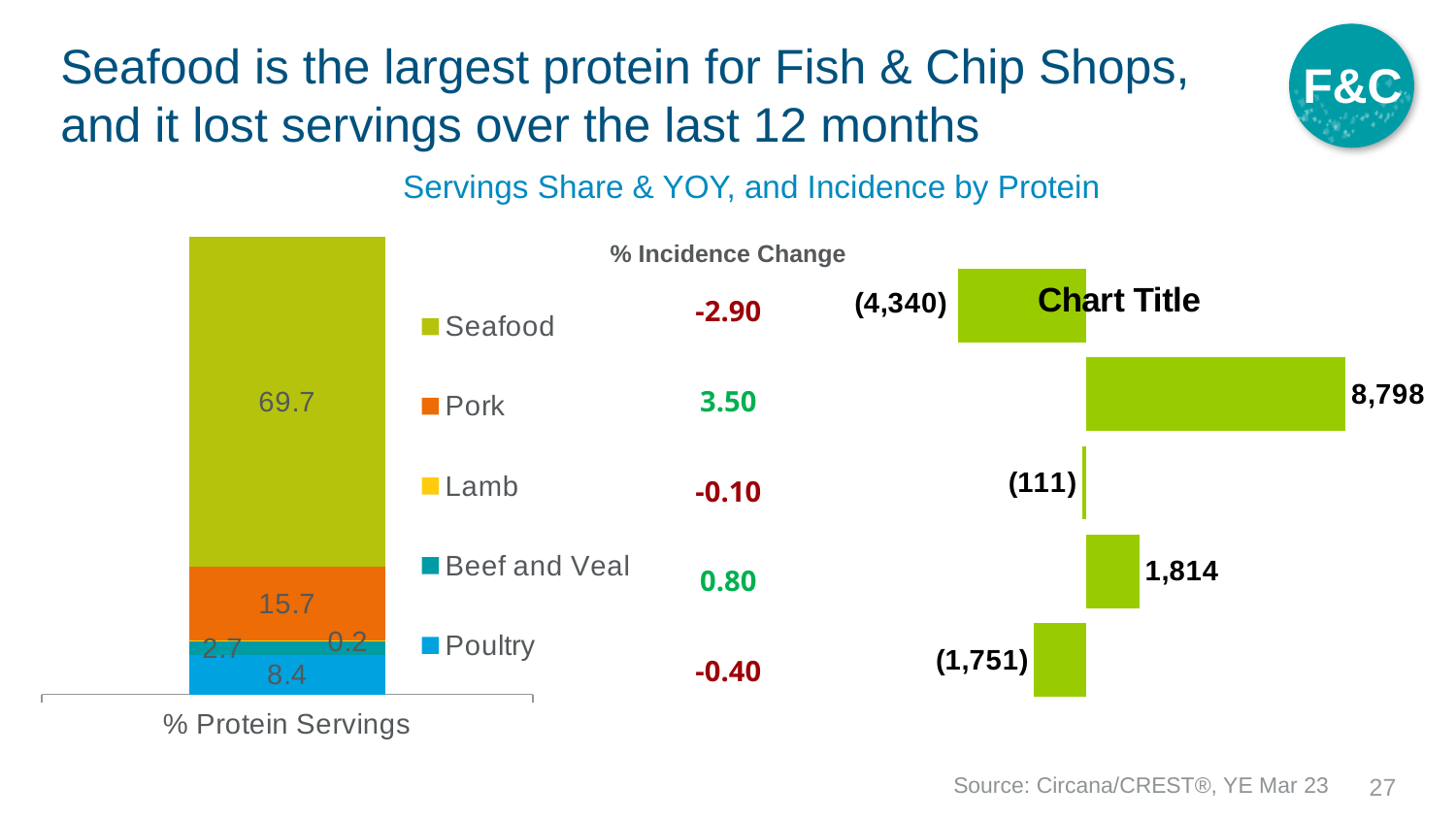
In the chart on the right titled "Chart Title", what is the value of the top bar? (4,340) In the chart on the right titled "Chart Title", what is the value of the bottom bar? (1,751) In the % Protein Servings stacked bar chart on the left, what is the value for Pork? 15.7 What kind of chart is the % Protein Servings chart on the left? Stacked bar chart In the % Protein Servings stacked bar chart on the left, which is larger, Pork or Poultry? Pork In the % Protein Servings stacked bar chart on the left, what is the value for Seafood? 69.7 How many series does the legend of the % Protein Servings chart on the left list? 5 In the chart on the right titled "Chart Title", what is the value of the second bar from the top? 8,798 In the % Protein Servings stacked bar chart on the left, which protein has the largest segment? Seafood In the % Protein Servings stacked bar chart on the left, which protein has the smallest segment? Lamb In the % Protein Servings stacked bar chart on the left, what is the value for Poultry? 8.4 In the % Protein Servings stacked bar chart on the left, what is the difference between the Seafood and Pork values? 54.0